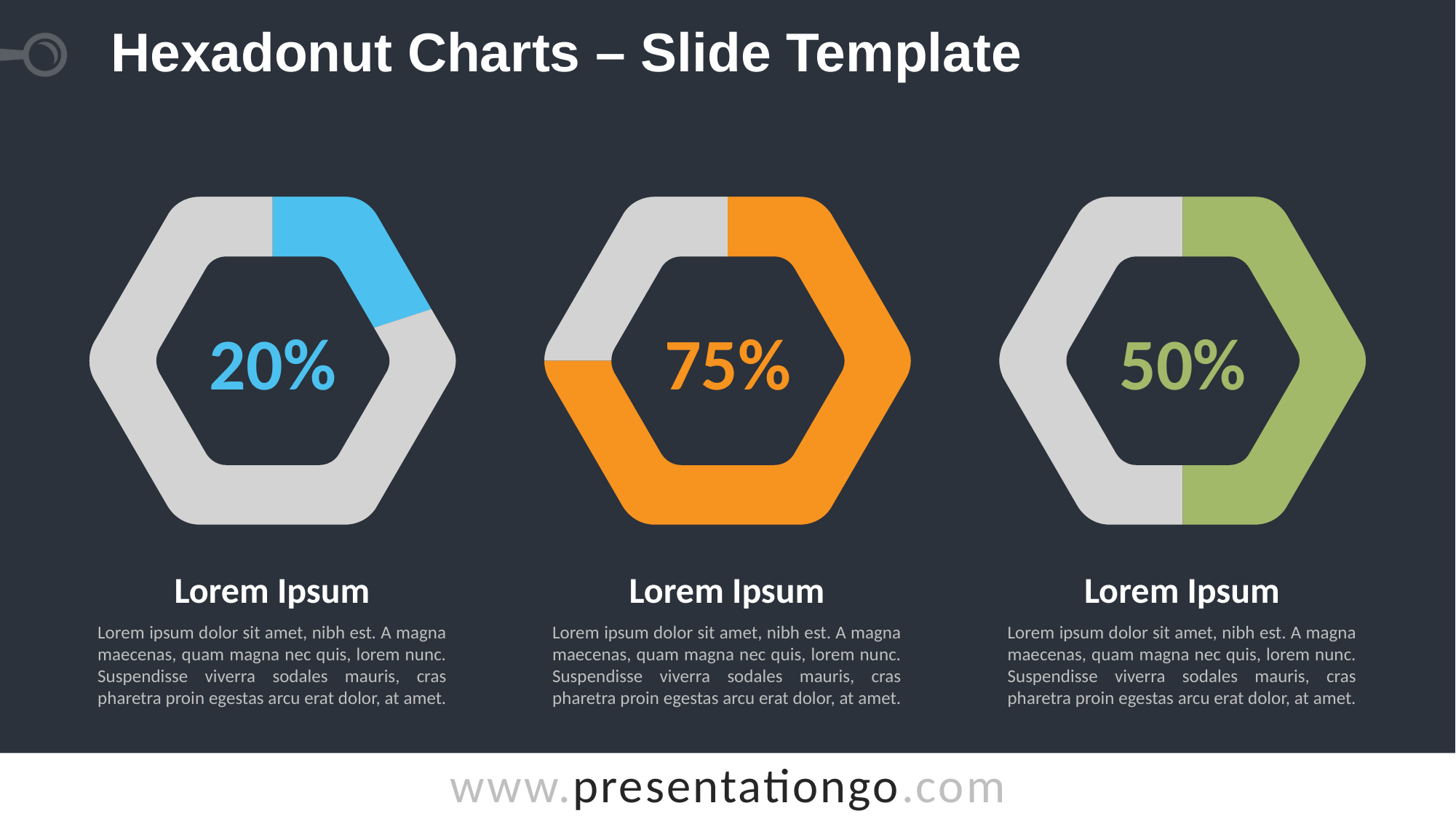
What is the difference between the percentage in the middle chart and the percentage in the left chart? 55% Which of the three hexadonut charts shows the highest percentage: left, middle or right? middle What is the difference between the percentage in the right chart and the percentage in the left chart? 30% What value is shown in the left hexadonut chart? 20% Which of the three hexadonut charts shows the lowest percentage: left, middle or right? left What value is shown in the middle hexadonut chart? 75% How many hexadonut charts are shown on the slide? 3 Which is larger, the value in the right chart or the value in the left chart? right chart What value is shown in the right hexadonut chart? 50% What colour is the filled portion of the left hexadonut chart? blue What colour is the filled portion of the middle hexadonut chart? orange What kind of chart is used on this slide? hexagonal donut chart